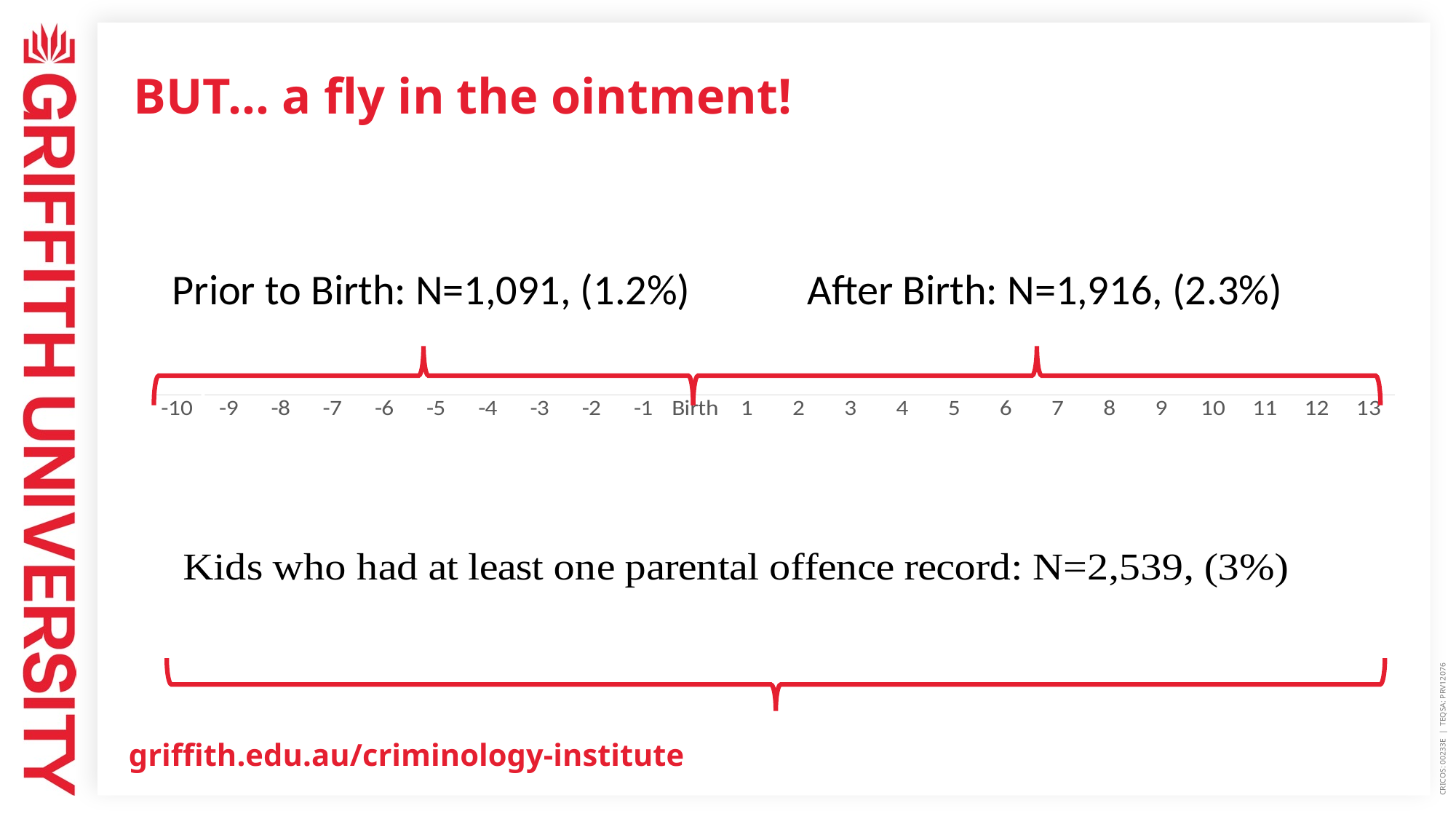
What is the highest value labelled on the timeline axis? 13 What is the N value shown for Prior to Birth? N=1,091 Which group has the larger N, Prior to Birth or After Birth? After Birth What label marks the midpoint of the timeline axis between -1 and 1? Birth What is the N value for kids who had at least one parental offence record? N=2,539 What percentage is shown for Prior to Birth? 1.2% What is the N value shown for After Birth? N=1,916 What percentage is shown for kids who had at least one parental offence record? 3% What percentage is shown for After Birth? 2.3% What is the lowest value labelled on the timeline axis? -10 What is the difference in percentage between After Birth and Prior to Birth? 1.1% What is the difference in N between After Birth and Prior to Birth? 825